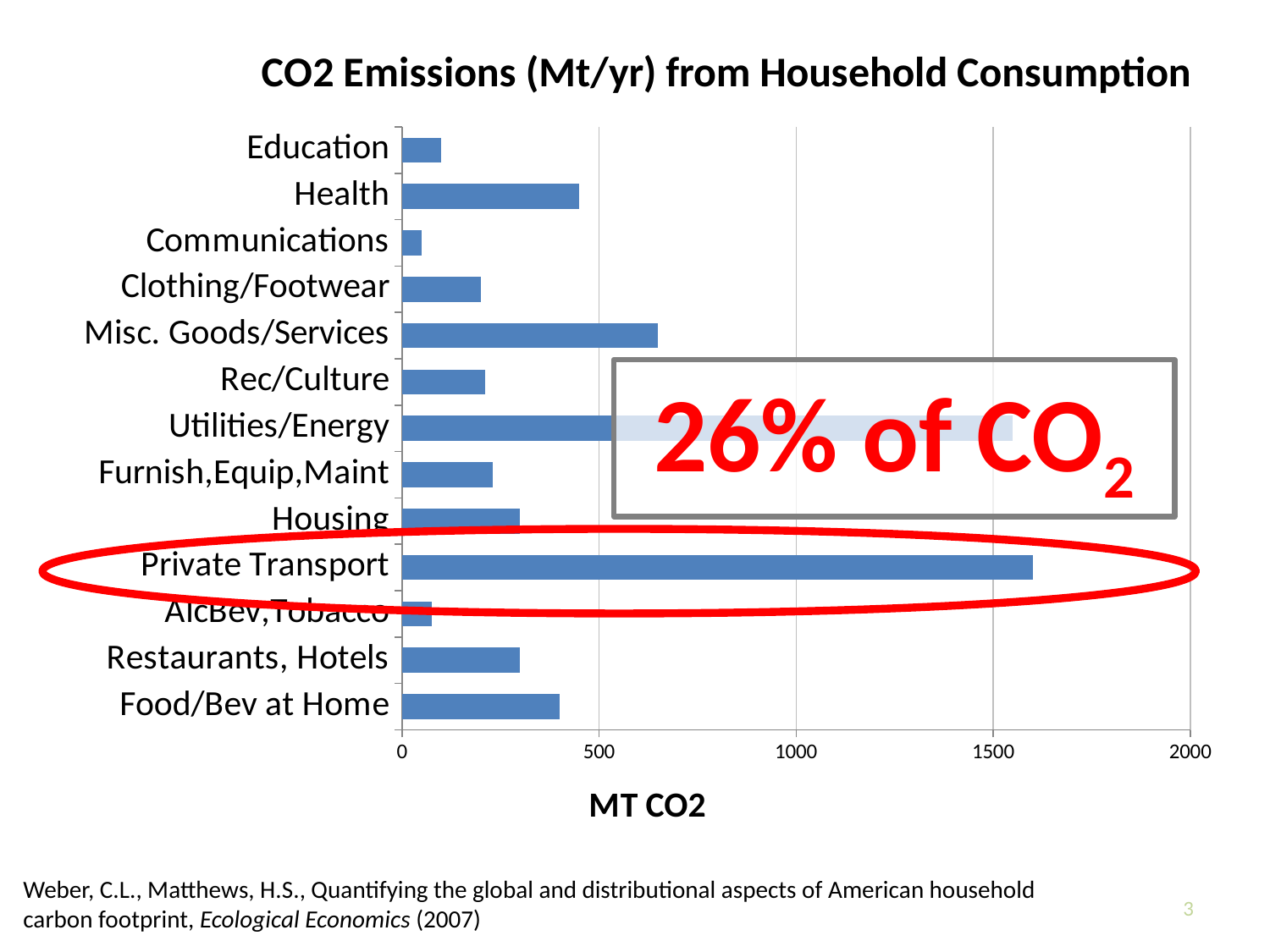
What kind of chart is shown on the slide? bar chart Is the value for Private Transport greater or less than 1500? greater Which is larger, the value for Clothing/Footwear or the value for Education? Clothing/Footwear Is the value for Health greater or less than 500? less What is the title of the chart? CO2 Emissions (Mt/yr) from Household Consumption Is the value for Education greater or less than 500? less Which is larger, the value for Misc. Goods/Services or the value for Health? Misc. Goods/Services How many categories are plotted in the chart? 13 What is the label on the horizontal axis of the chart? MT CO2 Which is larger, the value for Private Transport or the value for Housing? Private Transport